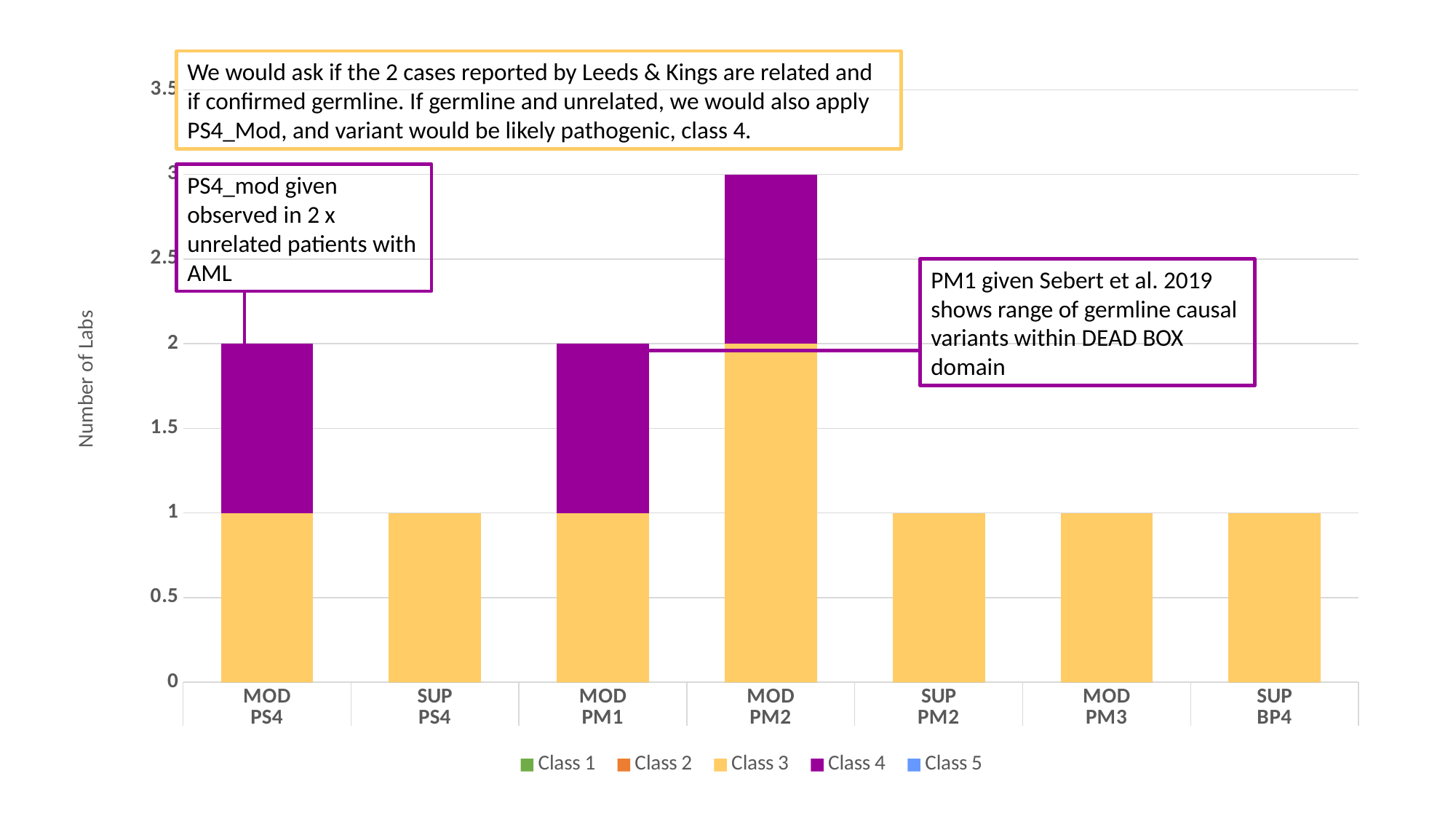
What is the Class 4 value for MOD PM1? 1 How many series does the legend list? 5 What is the total height of the stacked bar for MOD PM2? 3 What is the Class 3 value for MOD PM2? 2 What is the difference between the total for MOD PM2 and the total for MOD PM3? 2 What is the Class 3 value for SUP BP4? 1 Which category has the tallest stacked bar? MOD PM2 What is the label of the y axis? Number of Labs What is the total height of the stacked bar for MOD PS4? 2 What kind of chart is shown on the slide? Stacked bar chart How many categories are shown on the x axis? 7 Is the total for MOD PM2 larger than the total for SUP PM2? Yes